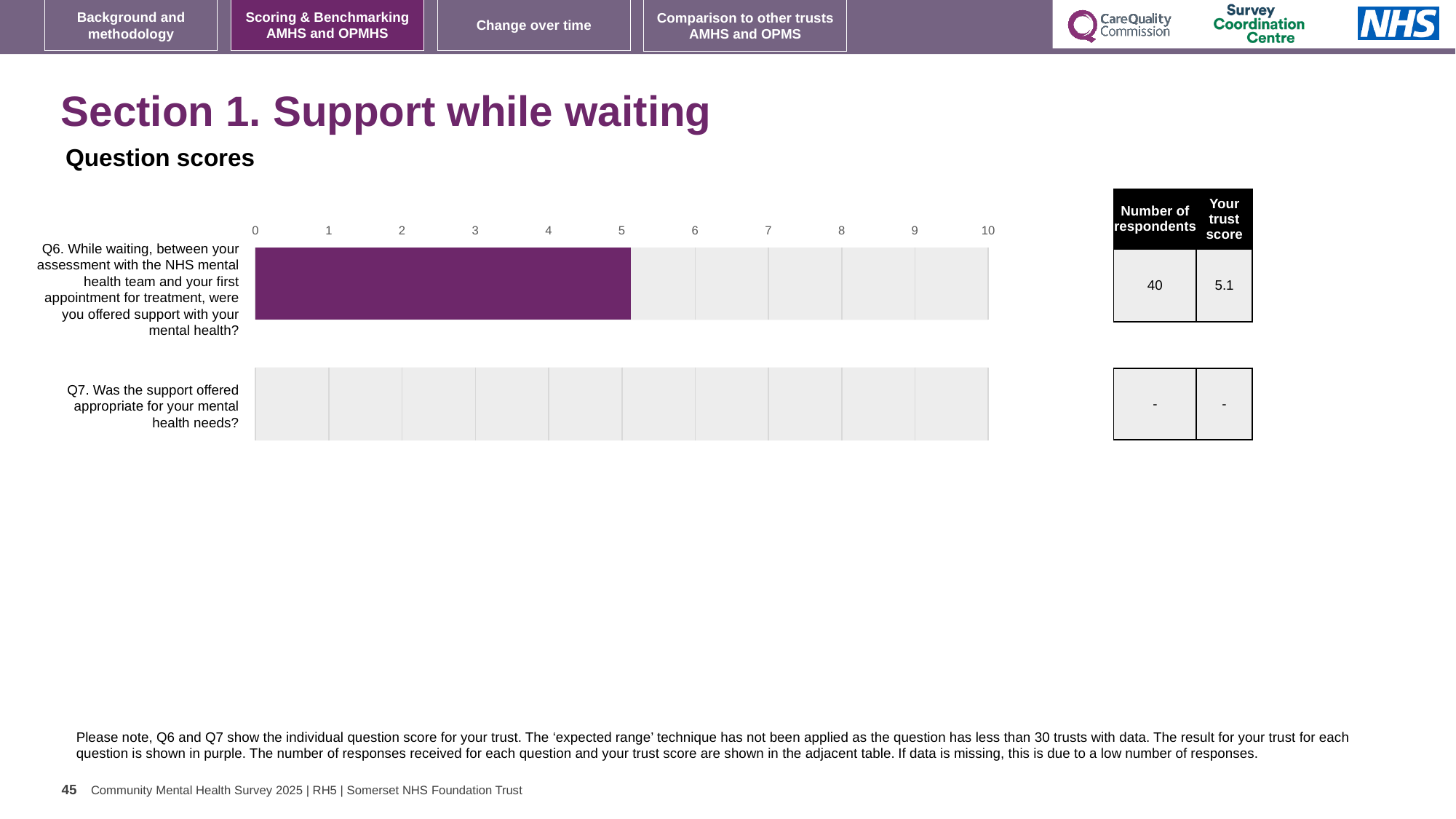
How many respondents answered Q6 according to the table? 40 Is the value of the bar for Q6 greater or less than 3? greater How many questions (categories) are listed on the chart? 2 Is the value of the bar for Q6 greater or less than 6? less What kind of chart is shown on the slide? bar chart Which question has a plotted bar on the chart, Q6 or Q7? Q6 What is the trust score for Q6 shown in the adjacent table? 5.1 Is the value of the bar for Q6 greater or less than 4? greater What is the highest value shown on the chart's horizontal axis? 10 What is the trust score shown in the table for Q7? - What colour is the bar showing the trust's result for Q6? purple